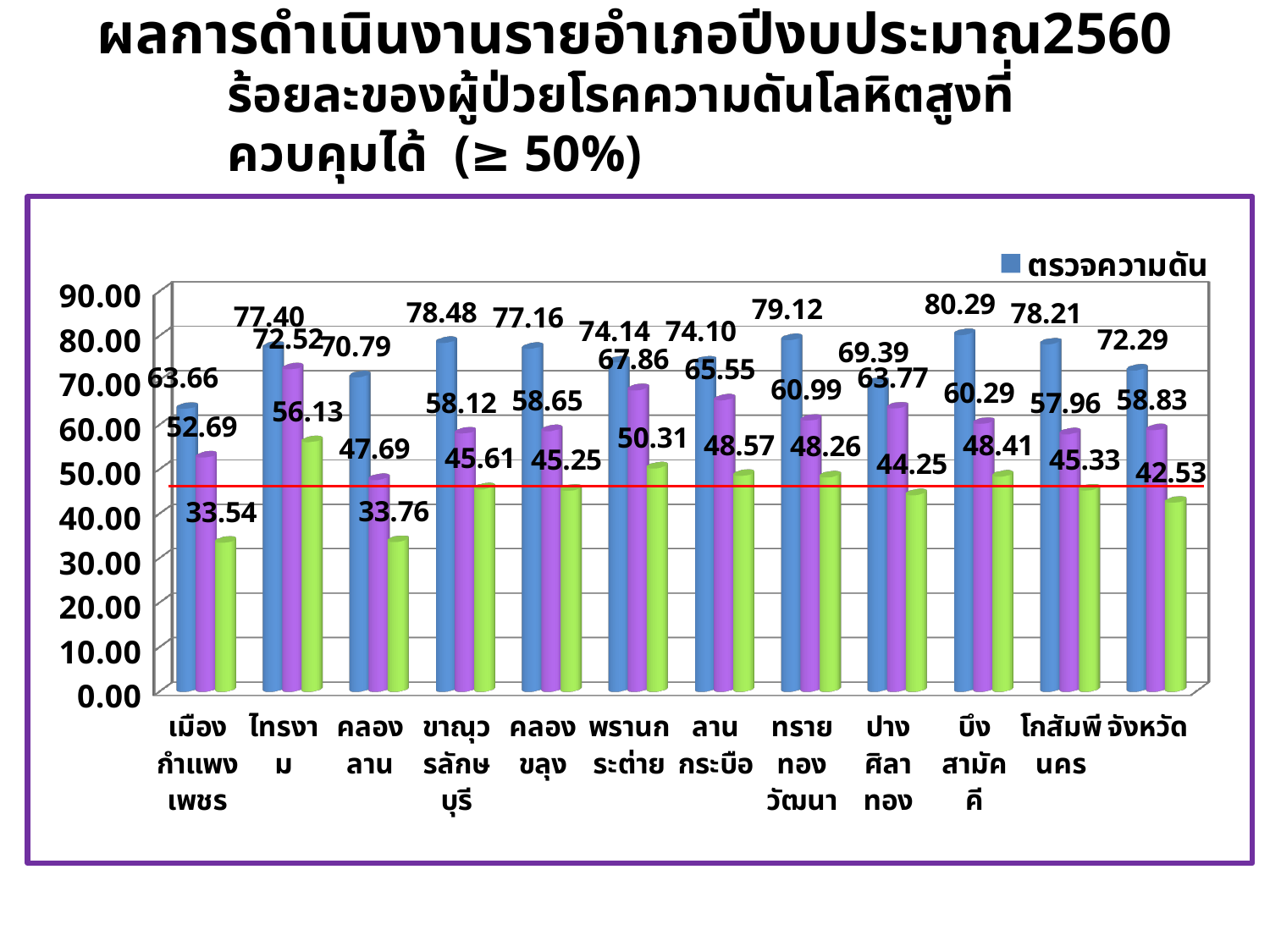
Which district has the highest blue (ตรวจความดัน) bar? บึงสามัคคี What is the value of the blue (ตรวจความดัน) bar for บึงสามัคคี? 80.29 How many categories (districts) are shown on the x axis? 12 What is the value of the purple bar for ไทรงาม? 72.52 What is the name of the series listed in the legend? ตรวจความดัน Which district has the lowest blue (ตรวจความดัน) bar? เมืองกำแพงเพชร How many series does the legend list? 1 Which is larger: the purple bar for ไทรงาม or the purple bar for พรานกระต่าย? ไทรงาม Which district has the lowest green bar? เมืองกำแพงเพชร What kind of chart is shown on the slide? Bar chart What is the value of the green bar for คลองลาน? 33.76 What is the difference between the blue bar (72.29) and the purple bar (58.83) for จังหวัด? 13.46